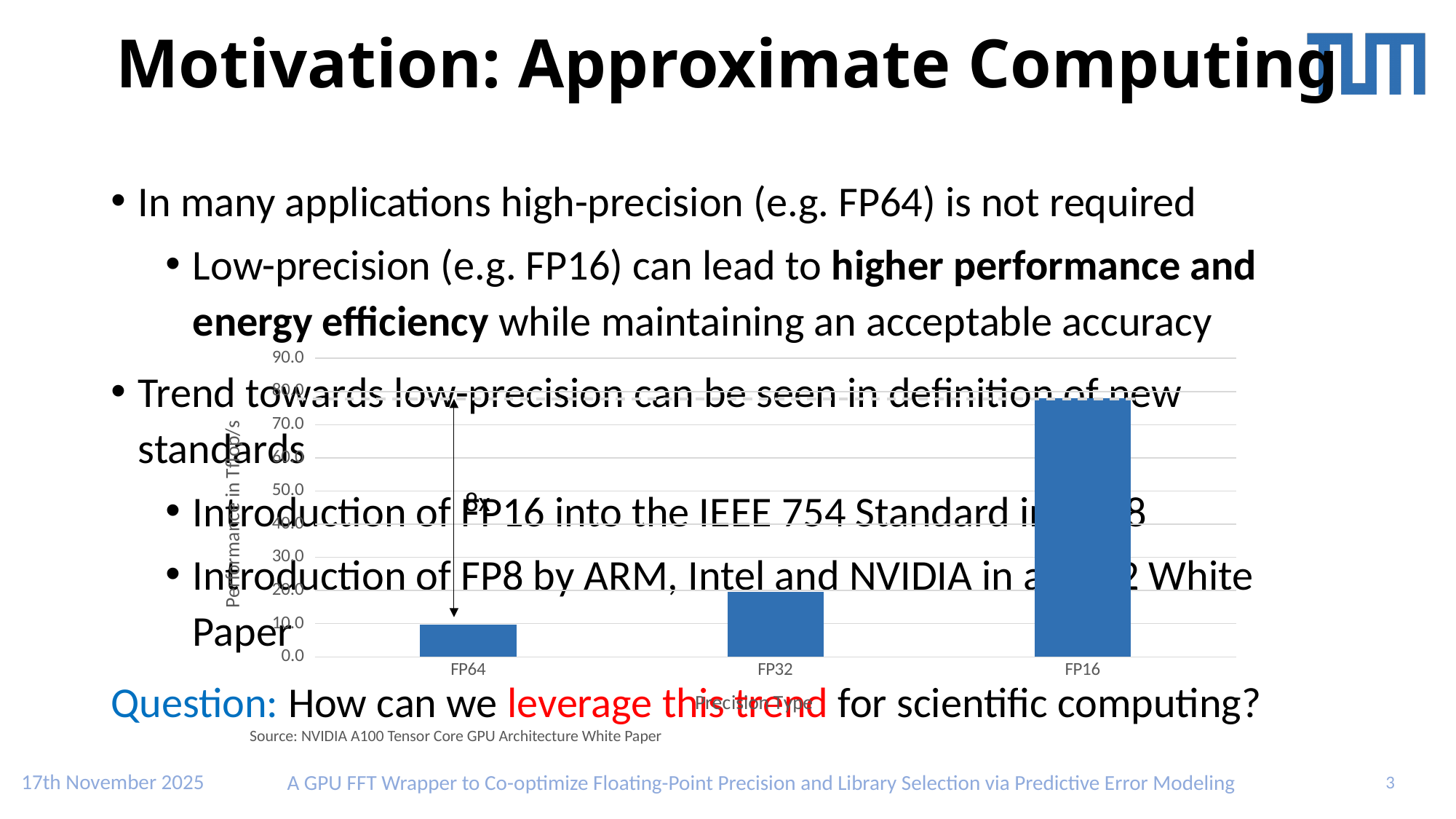
What is the label on the x axis of the chart? Precision Type Which precision type has the lowest bar in the chart? FP64 Is the value for FP64 greater or less than 20.0? less What factor is annotated by the arrow between the FP64 bar and the dashed line at the FP16 level? 8x What kind of chart is shown on the slide? bar chart How many precision types are plotted on the x axis of the chart? 3 Do the bar values rise or fall moving from FP64 to FP16 along the x axis? rise Which has the larger value in the chart, FP32 or FP64? FP32 Is the value for FP32 greater or less than 30.0? less Which precision type has the highest bar in the chart? FP16 Which has the larger value in the chart, FP16 or FP32? FP16 Is the value for FP16 greater or less than 70.0? greater